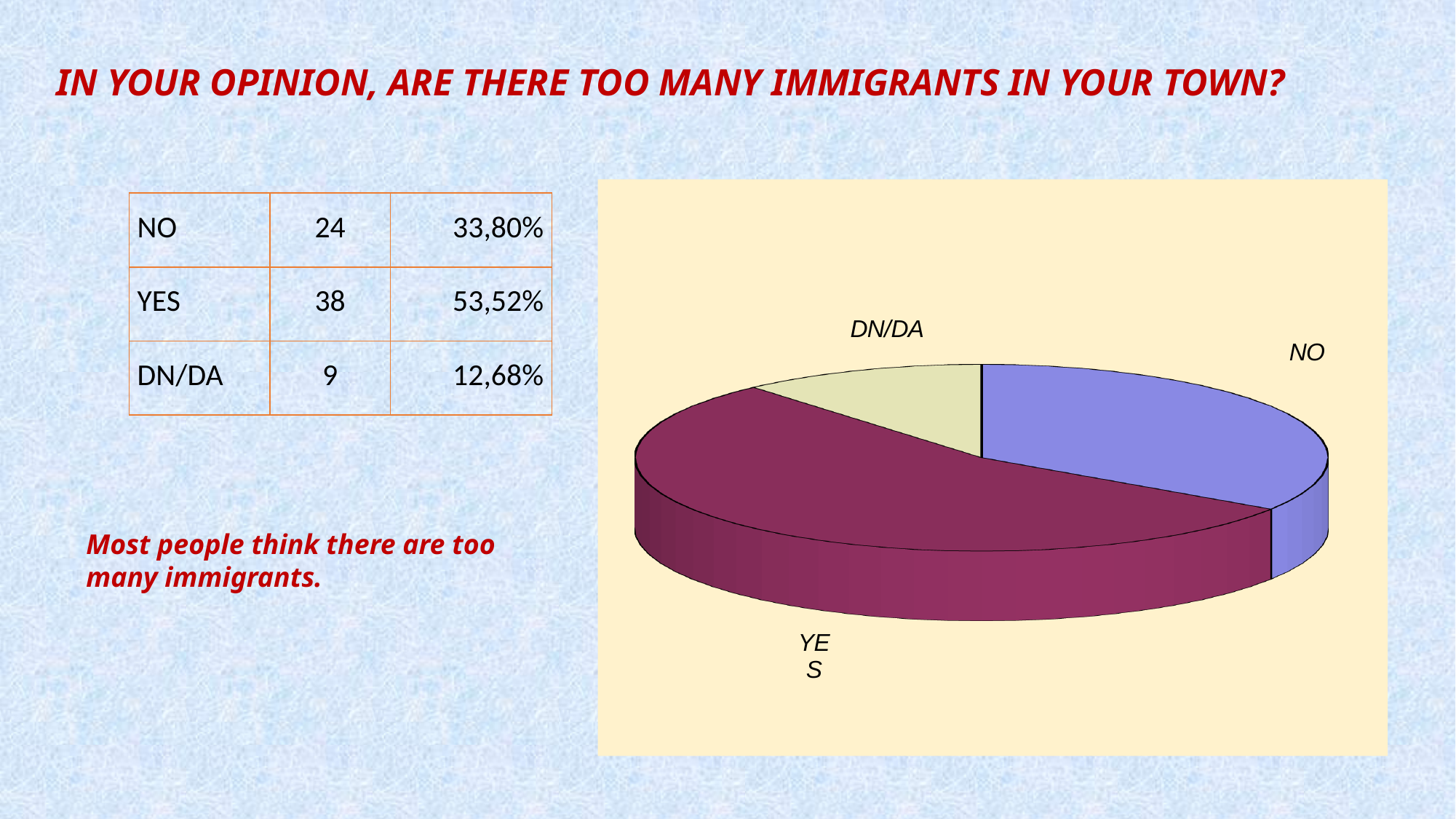
According to the table on the slide, how many respondents answered YES? 38 According to the table on the slide, what percentage of respondents answered NO? 33,80% Which slice of the pie chart is the smallest? DN/DA How many slices does the pie chart have? 3 Which is larger in the pie chart, the NO slice or the DN/DA slice? NO According to the table on the slide, what percentage of respondents answered YES? 53,52% Using the counts in the table, how many more respondents answered YES than NO? 14 What kind of chart is shown on the slide? pie chart According to the table on the slide, what percentage of respondents answered DN/DA? 12,68% Which slice of the pie chart is the largest? YES What colour is the YES slice in the pie chart? purple According to the table on the slide, how many respondents answered DN/DA? 9